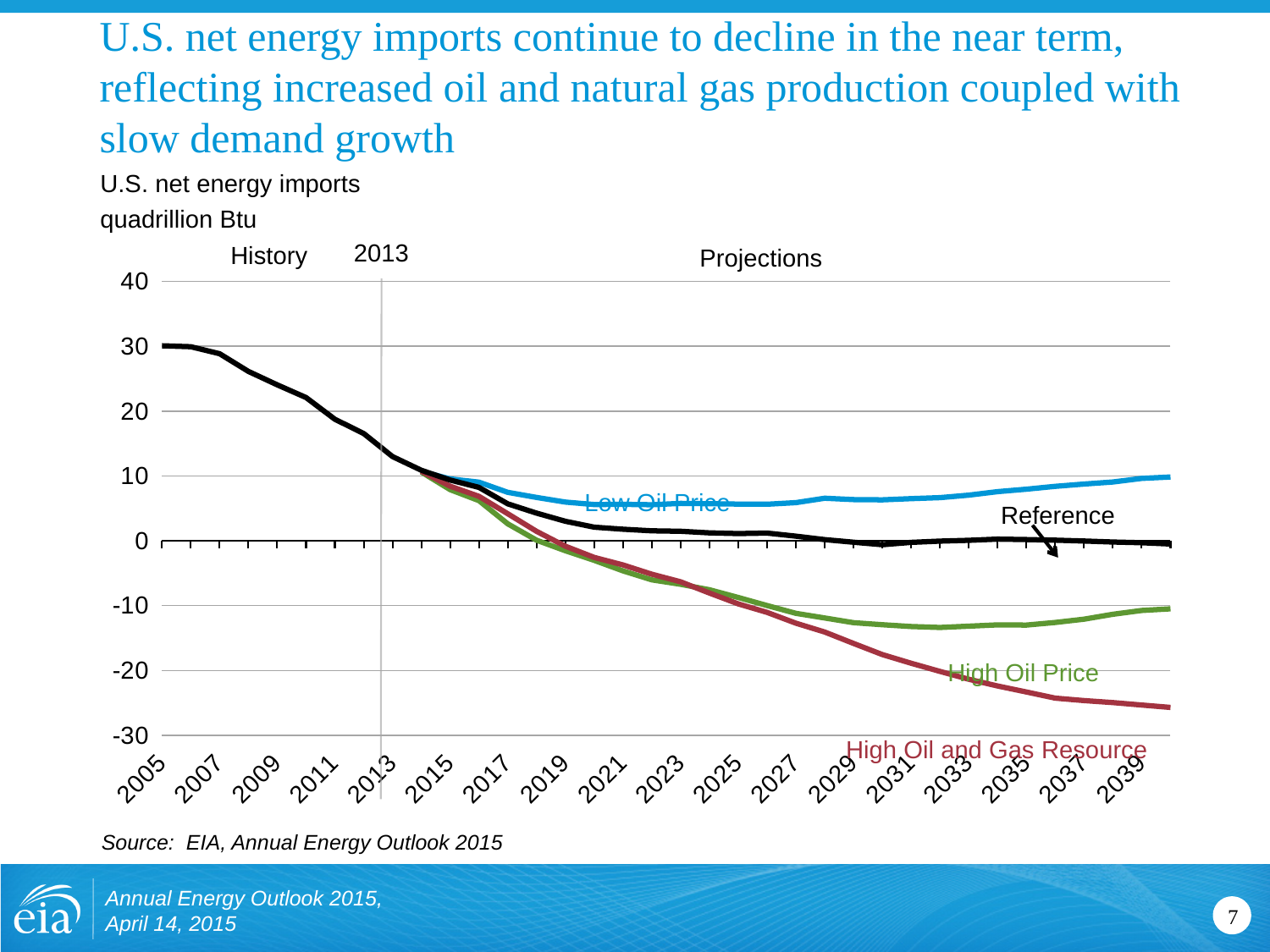
Is the value for Low Oil Price in 2025 greater or less than 0? greater In 2039, which is larger: the Low Oil Price value or the High Oil and Gas Resource value? Low Oil Price Which series has the highest value in 2039? Low Oil Price What unit is used on the y axis of the chart? quadrillion Btu Which year marks the boundary between History and Projections on the chart? 2013 Is the value for High Oil Price in 2033 greater or less than -10? less Which series has the lowest value in 2039? High Oil and Gas Resource Is the historical value in 2009 greater or less than 20? greater Do U.S. net energy imports rise or fall over the history period from 2005 to 2013? fall What kind of chart is shown on the slide? line chart How many projection series (labelled lines) are plotted on the chart? 4